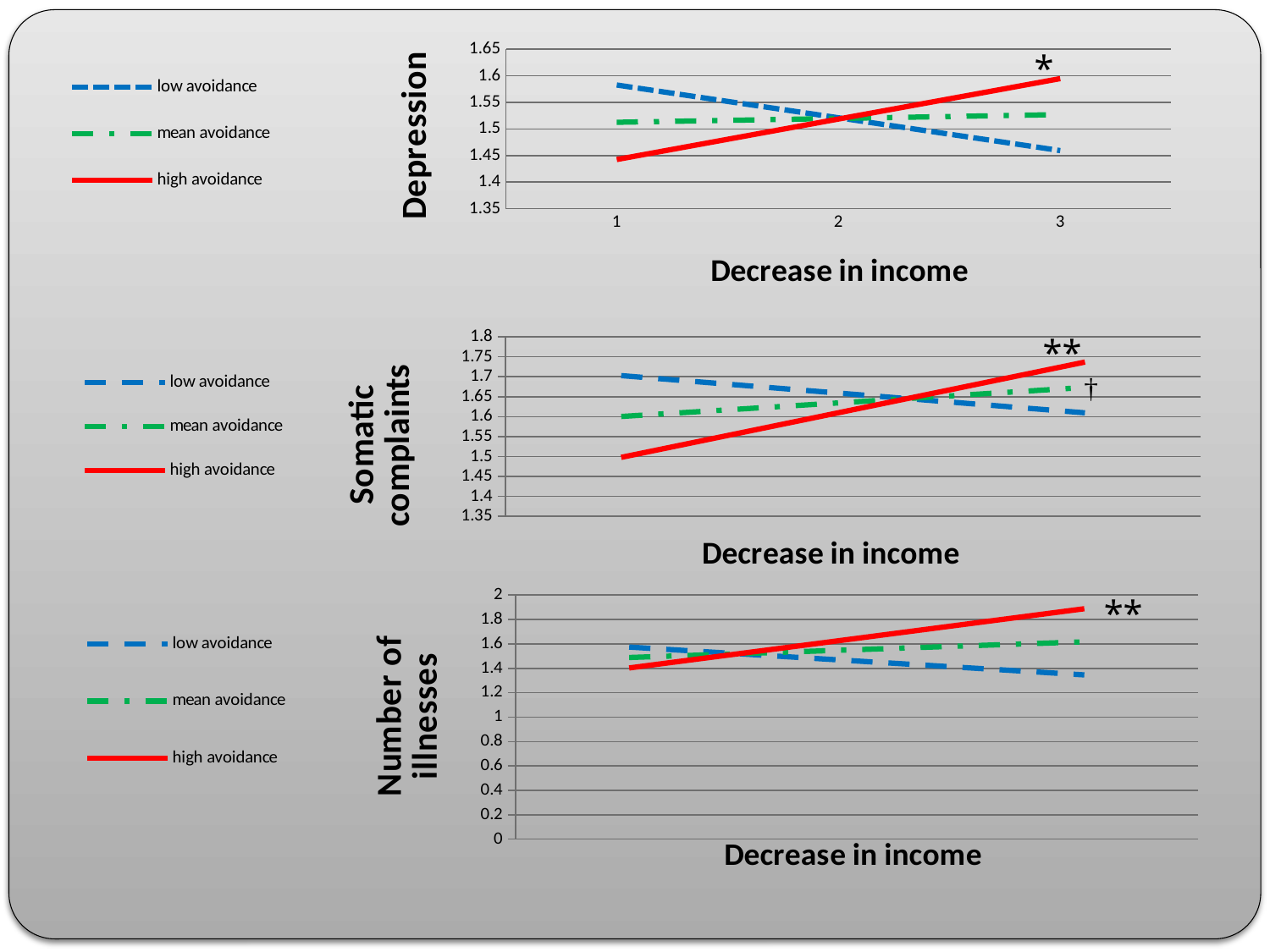
In the Number of illnesses chart, which series has the larger value at decrease in income 3, high avoidance or low avoidance? high avoidance What kind of chart is the Depression chart? line chart How many points are plotted along the x axis of the Depression chart? 3 In the Number of illnesses chart, is the high avoidance value at decrease in income 3 greater or less than 1.8? greater What is the x-axis title shared by all three charts? Decrease in income How many series does the legend of the Depression chart list? 3 In the Somatic complaints chart, is the high avoidance value at decrease in income 3 greater or less than 1.7? greater In the Depression chart, does the high avoidance line rise or fall as decrease in income goes from 1 to 3? rise In the Depression chart, is the high avoidance value at decrease in income 3 greater or less than 1.55? greater In the Depression chart, does the low avoidance line rise or fall as decrease in income goes from 1 to 3? fall